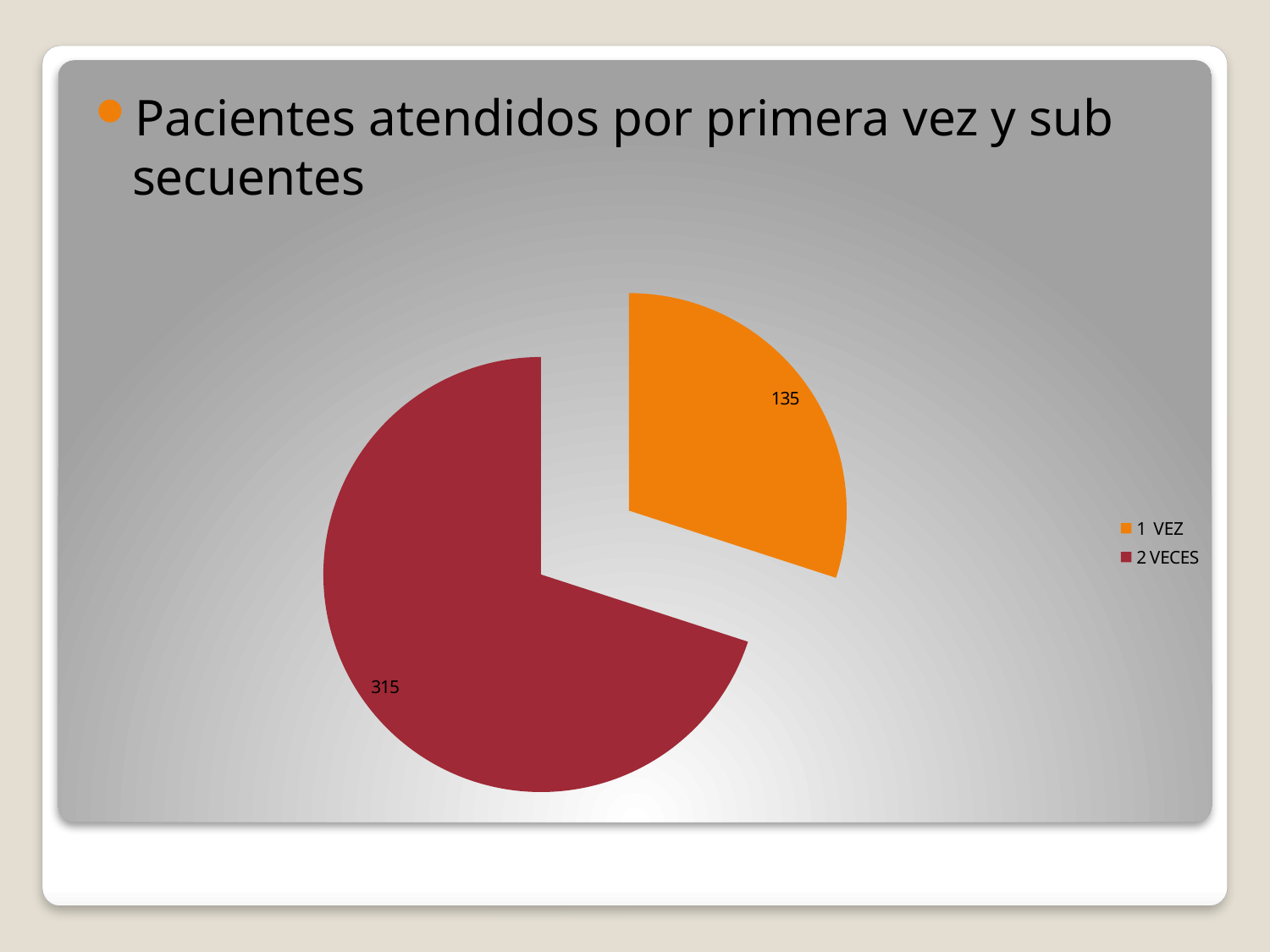
Which category has the largest slice of the pie? 2 VECES How many entries does the legend list? 2 Which category has the smallest slice of the pie? 1 VEZ How many slices does the pie chart have? 2 What is the value for the "2 VECES" slice? 315 What is the difference between the "2 VECES" value and the "1 VEZ" value? 180 What is the value for the "1 VEZ" slice? 135 What share of the pie does the "2 VECES" slice represent? 70% What kind of chart is shown on the slide? Pie chart Which is larger, the value for "1 VEZ" or the value for "2 VECES"? 2 VECES What colour is the "1 VEZ" slice? Orange What is the total of the two slices in the pie chart? 450